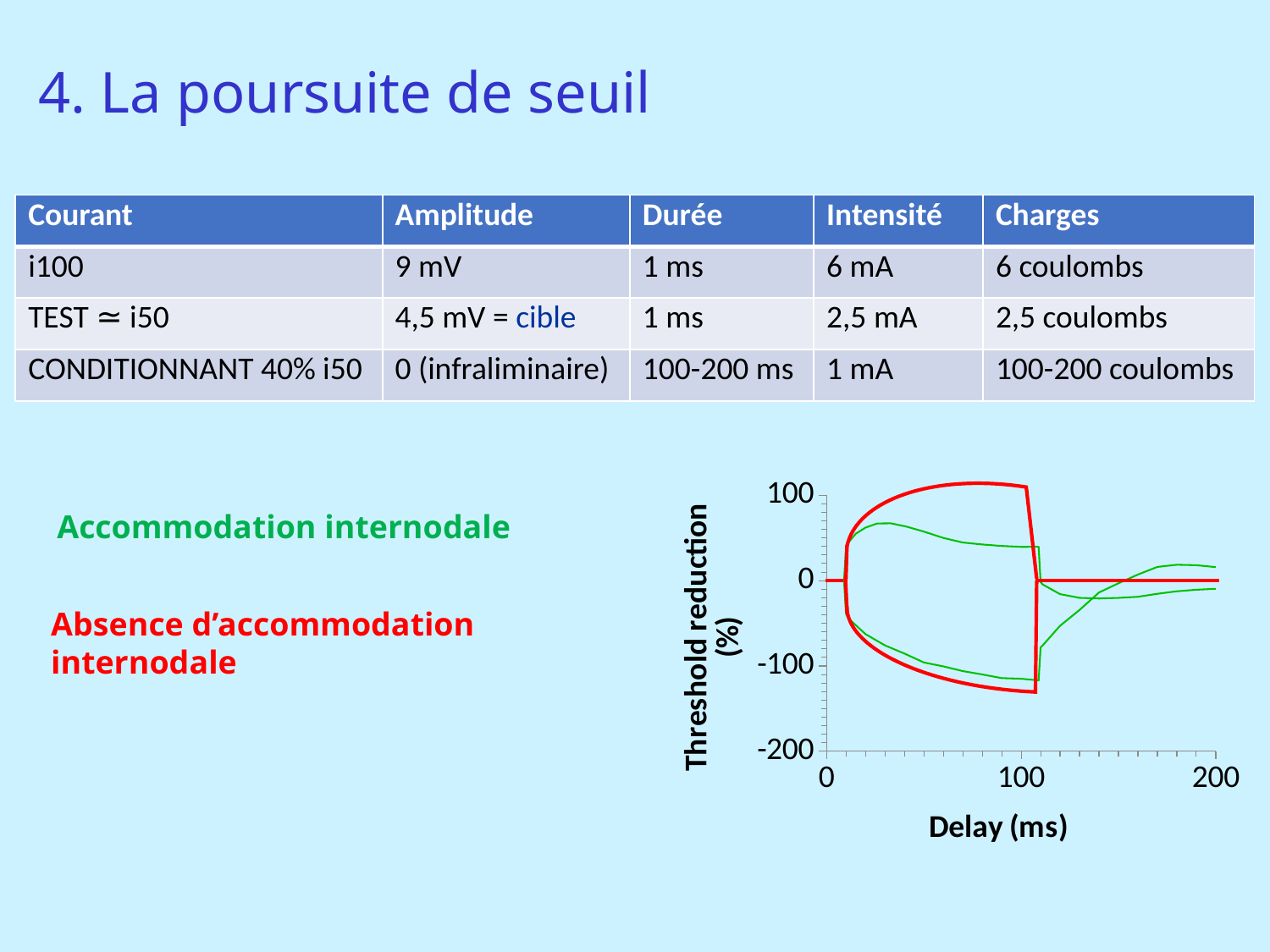
Is the value of the upper green curve at a delay of 50 ms greater or less than 0? greater Between a delay of 0 ms and 100 ms, does the lower red curve rise or fall? fall Between a delay of 0 ms and 100 ms, does the upper red curve rise or fall? rise What is the highest value shown on the y axis of the chart? 100 What is the title of the x axis of the chart? Delay (ms) What kind of chart is shown on the slide? line chart Is the value of the upper red curve at a delay of 50 ms greater or less than 0? greater Is the value of the lower red curve at a delay of 100 ms greater or less than -100? less What is the lowest value shown on the y axis of the chart? -200 What is the highest value shown on the x axis of the chart? 200 What is the title of the y axis of the chart? Threshold reduction (%)